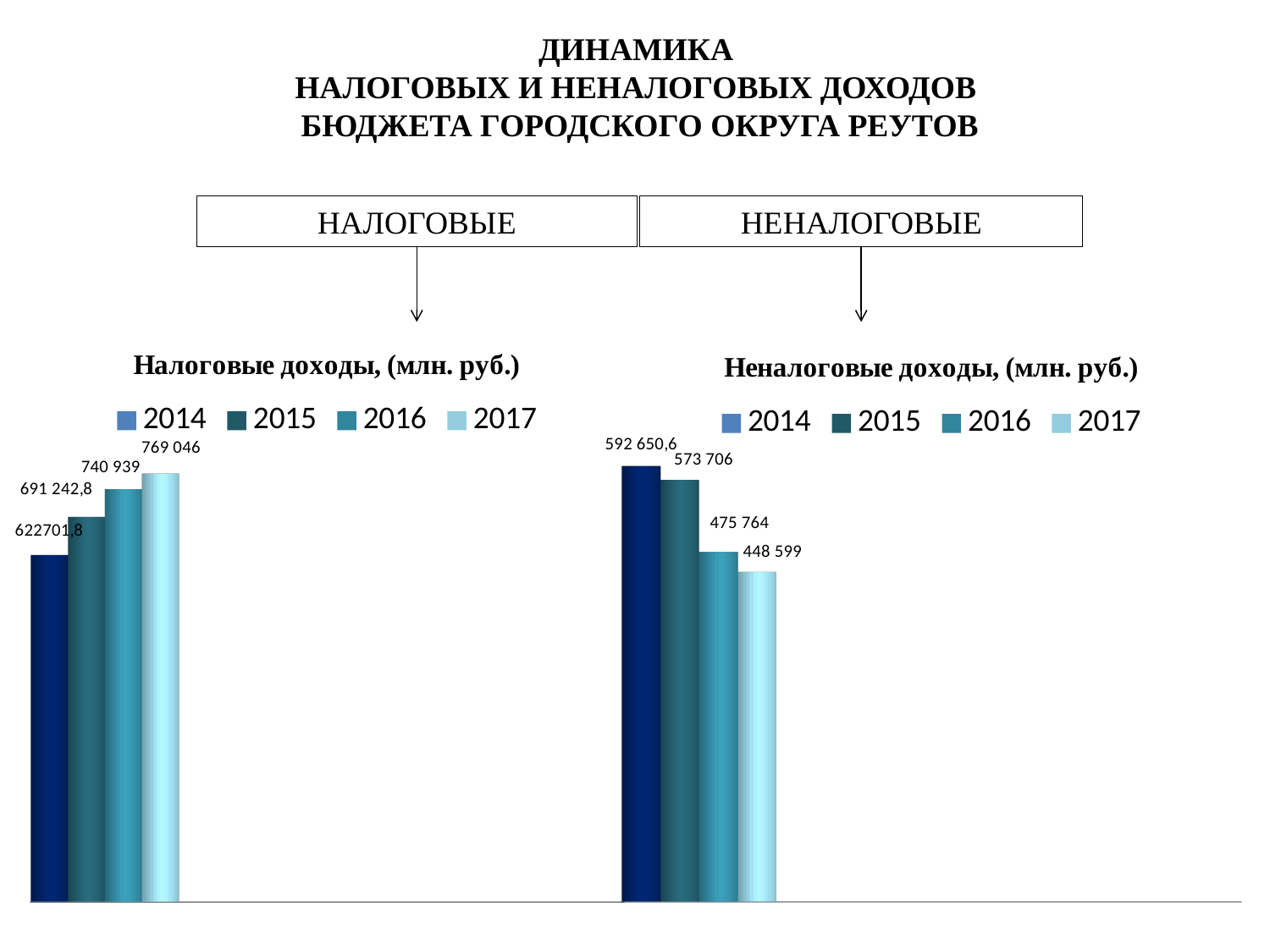
How many series does the legend of the chart titled "Неналоговые доходы, (млн. руб.)" list? 4 In the chart titled "Налоговые доходы, (млн. руб.)", what is the value for 2014? 622701,8 In the chart titled "Налоговые доходы, (млн. руб.)", do the values rise or fall from 2014 to 2017? rise In the chart titled "Неналоговые доходы, (млн. руб.)", which is larger, the value for 2014 or the value for 2015? 2014 In the chart titled "Налоговые доходы, (млн. руб.)", what is the value for 2017? 769 046 In the chart titled "Неналоговые доходы, (млн. руб.)", what is the difference between the 2016 and 2017 values? 27 165 In the chart titled "Налоговые доходы, (млн. руб.)", which year has the highest value? 2017 In the chart titled "Неналоговые доходы, (млн. руб.)", what is the value for 2015? 573 706 In the chart titled "Неналоговые доходы, (млн. руб.)", which year has the lowest value? 2017 In the chart titled "Налоговые доходы, (млн. руб.)", what is the difference between the 2016 and 2015 values? 49 696,2 In the chart titled "Неналоговые доходы, (млн. руб.)", which year has the highest value? 2014 In the chart titled "Неналоговые доходы, (млн. руб.)", what is the value for 2016? 475 764